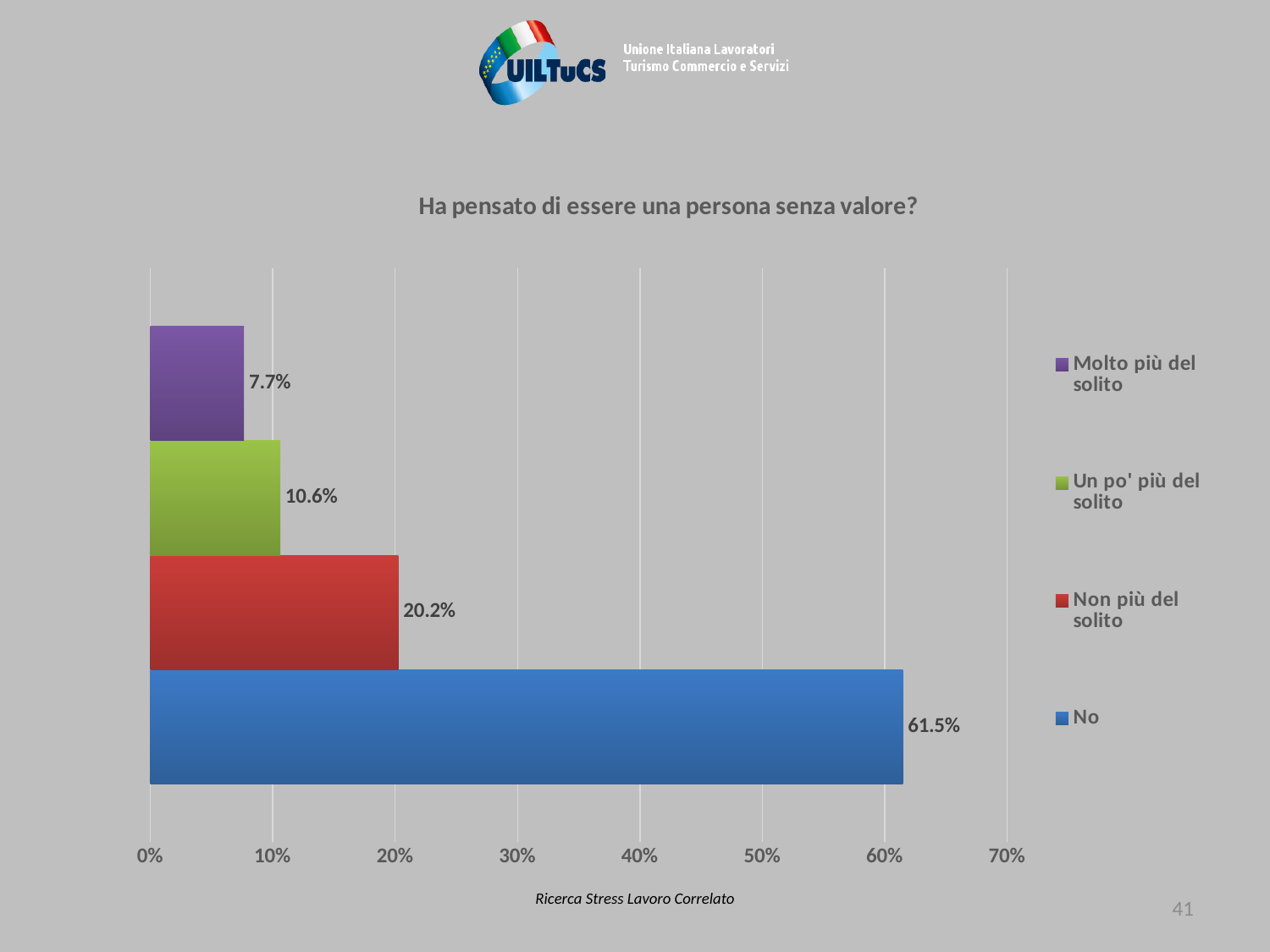
What is the value for "Molto più del solito"? 7.7% What is the title of the chart? Ha pensato di essere una persona senza valore? How many categories does the legend list? 4 Which category has the lowest value? Molto più del solito What is the difference between the values for "No" and "Non più del solito"? 41.3% Is the value for "No" greater or less than 60%? greater What is the value for "Non più del solito"? 20.2% What is the value for "No"? 61.5% Which is larger, the value for "Un po' più del solito" or the value for "Molto più del solito"? Un po' più del solito Which category has the highest value? No What is the value for "Un po' più del solito"? 10.6% What kind of chart is shown on the slide? Bar chart